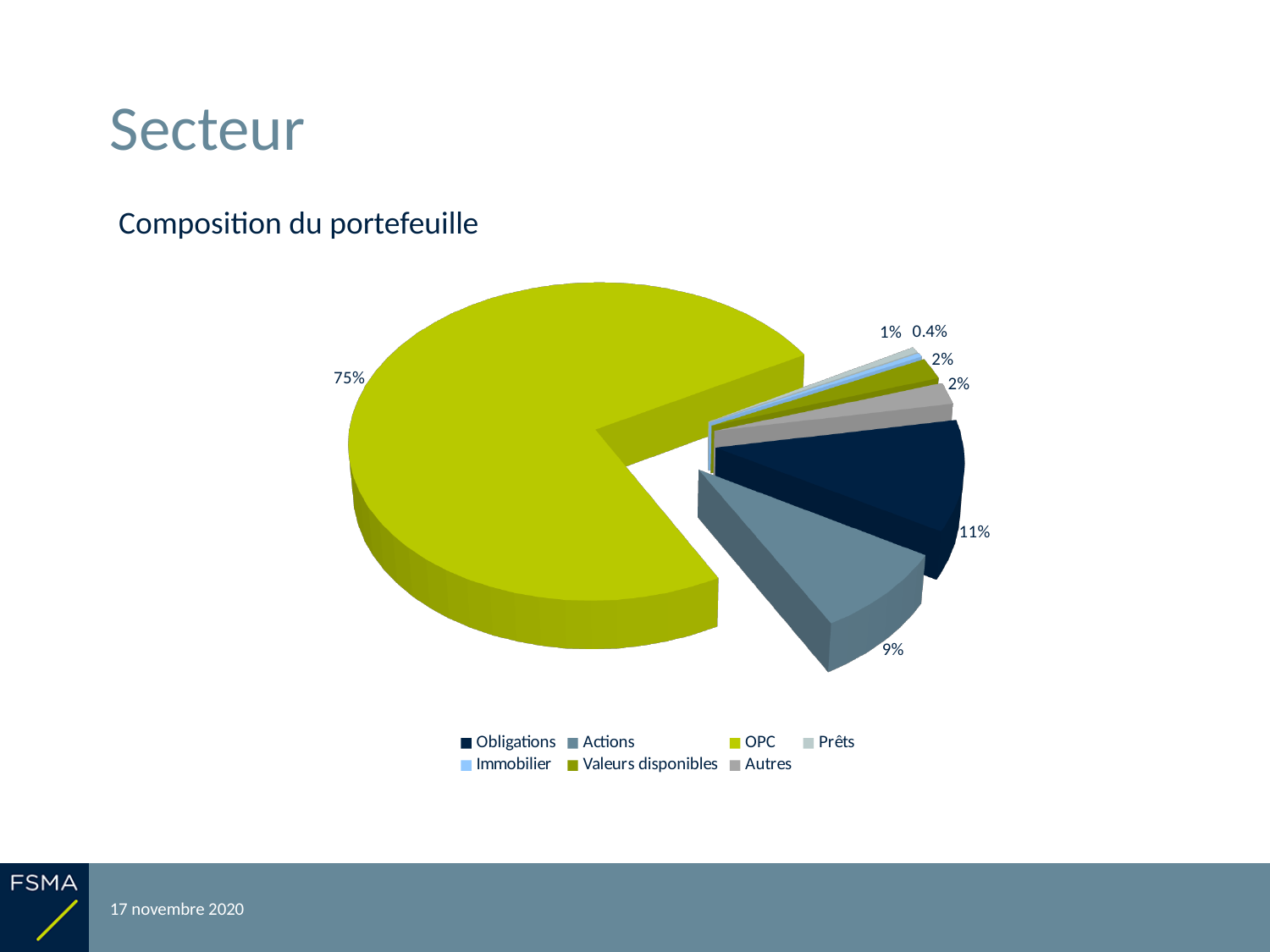
What is the difference between the OPC share and the Obligations share? 64% Which is larger, the share for Obligations or the share for Actions? Obligations How many categories does the legend of the pie chart list? 7 What is the smallest percentage shown on the pie chart? 0.4% What type of chart is shown on the slide? pie chart Which legend entry is shown in yellow-green? OPC Which category has the largest share of the pie? OPC What share of the portfolio is Obligations? 11% What share of the portfolio is OPC? 75% What is the title of the chart? Composition du portefeuille What share of the portfolio is Actions? 9% What is the difference between the Obligations share and the Actions share? 2%